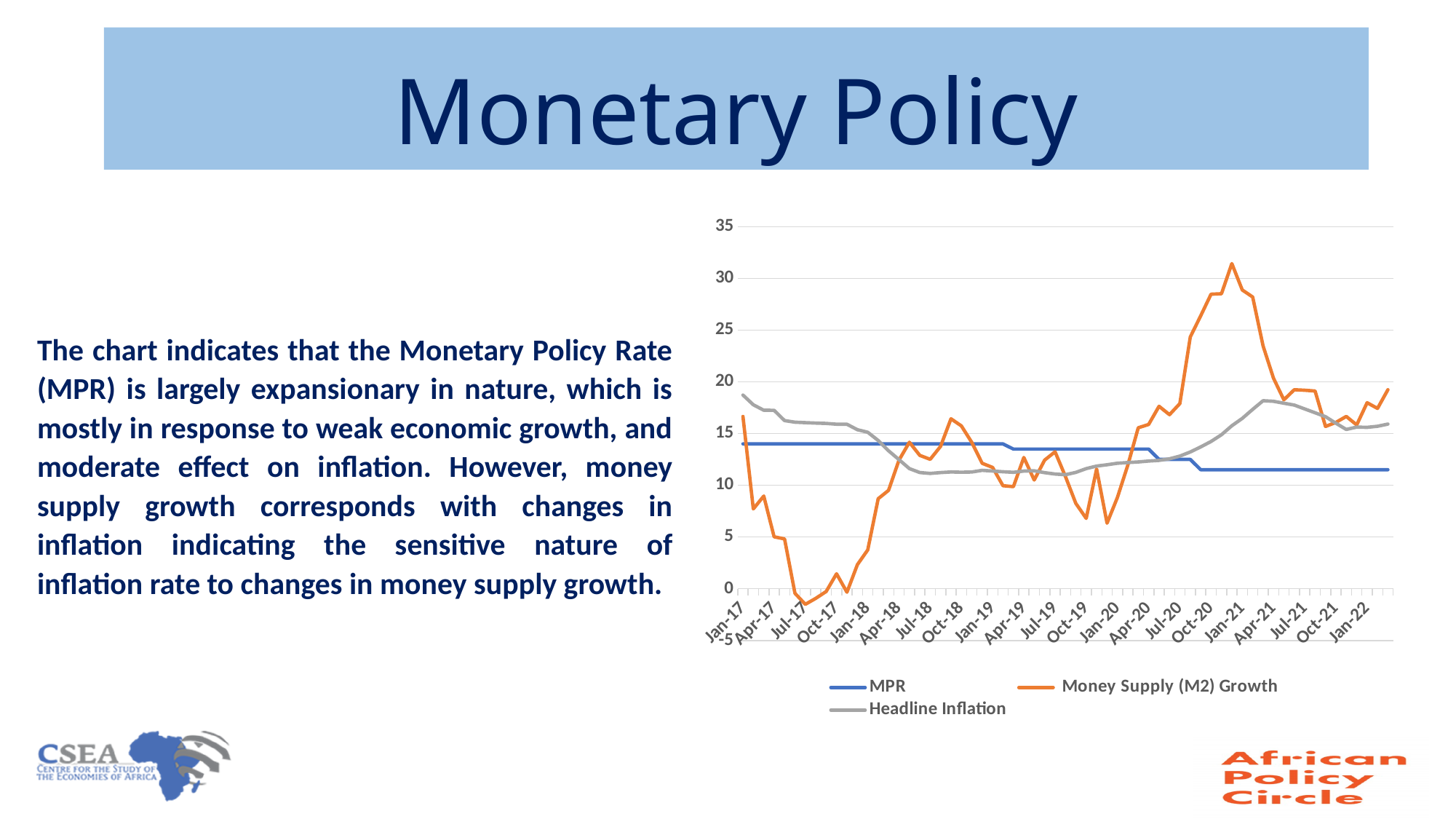
What kind of chart is shown on the slide? Line chart At Jan-21, which is higher: Money Supply (M2) Growth or Headline Inflation? Money Supply (M2) Growth Does the MPR line rise or fall overall from Jan-17 to Jan-22? Fall Is the value of MPR at Jan-22 greater or less than 10? greater Is the value of Headline Inflation at Jan-17 greater or less than 15? greater Is the value of Money Supply (M2) Growth at Jul-17 greater or less than 5? less How many series does the chart legend list? 3 Which series is drawn in orange on the chart? Money Supply (M2) Growth Which series reaches the highest value anywhere on the chart? Money Supply (M2) Growth At Jul-17, which is higher: MPR or Money Supply (M2) Growth? MPR What is the highest value shown on the chart's vertical axis? 35